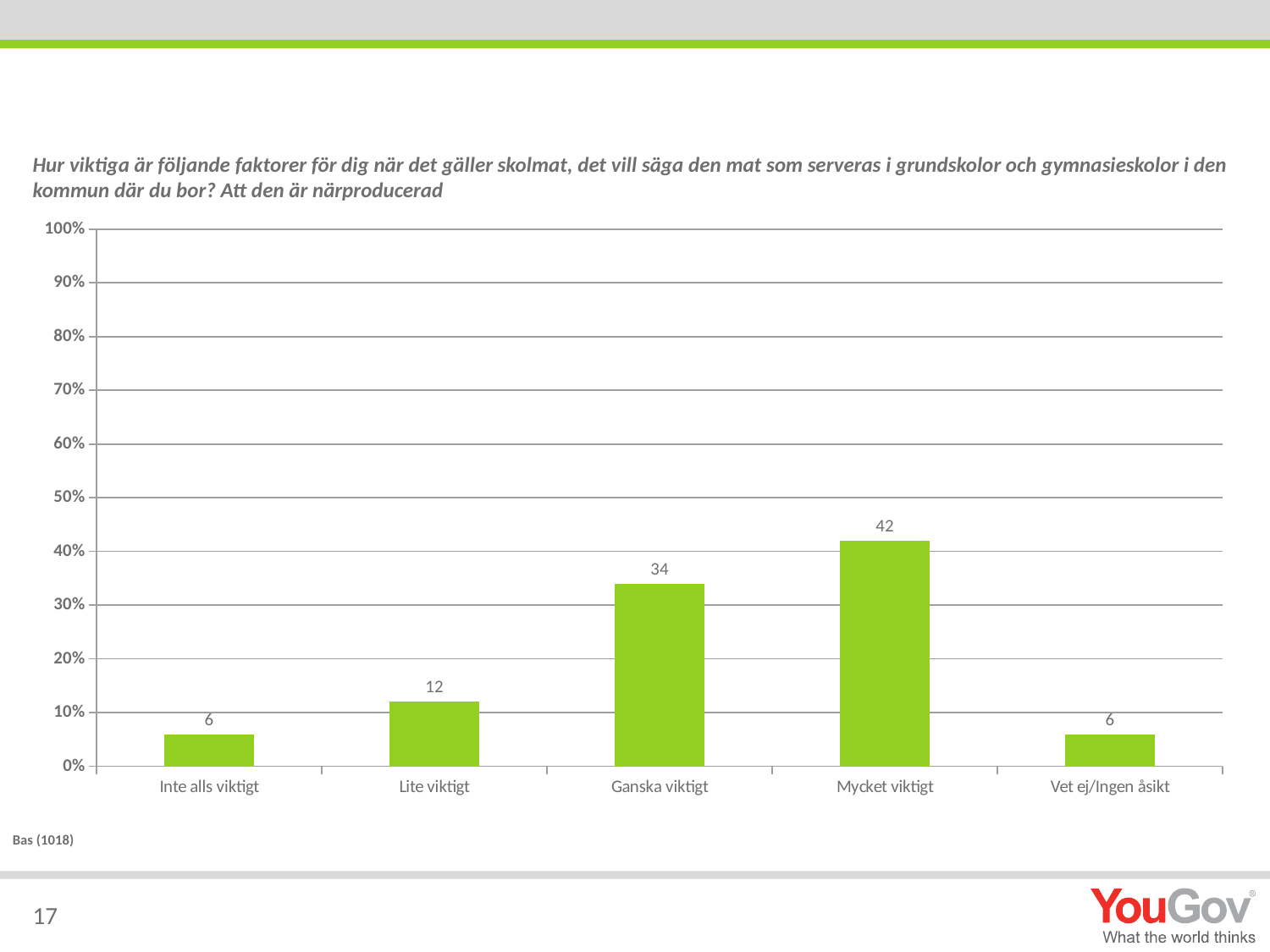
Is the value for "Inte alls viktigt" greater or less than 10%? less What is the difference between the values for "Lite viktigt" and "Inte alls viktigt"? 6 What is the base (Bas) shown below the chart? 1018 What is the value for "Ganska viktigt"? 34 What is the value for "Mycket viktigt"? 42 Which is larger, the value for "Ganska viktigt" or the value for "Lite viktigt"? Ganska viktigt What kind of chart is shown on the slide? Bar chart Is the value for "Mycket viktigt" greater or less than 40%? greater Which category has the highest value? Mycket viktigt How many categories are shown on the x axis? 5 What is the value for "Lite viktigt"? 12 What is the difference between the values for "Mycket viktigt" and "Ganska viktigt"? 8